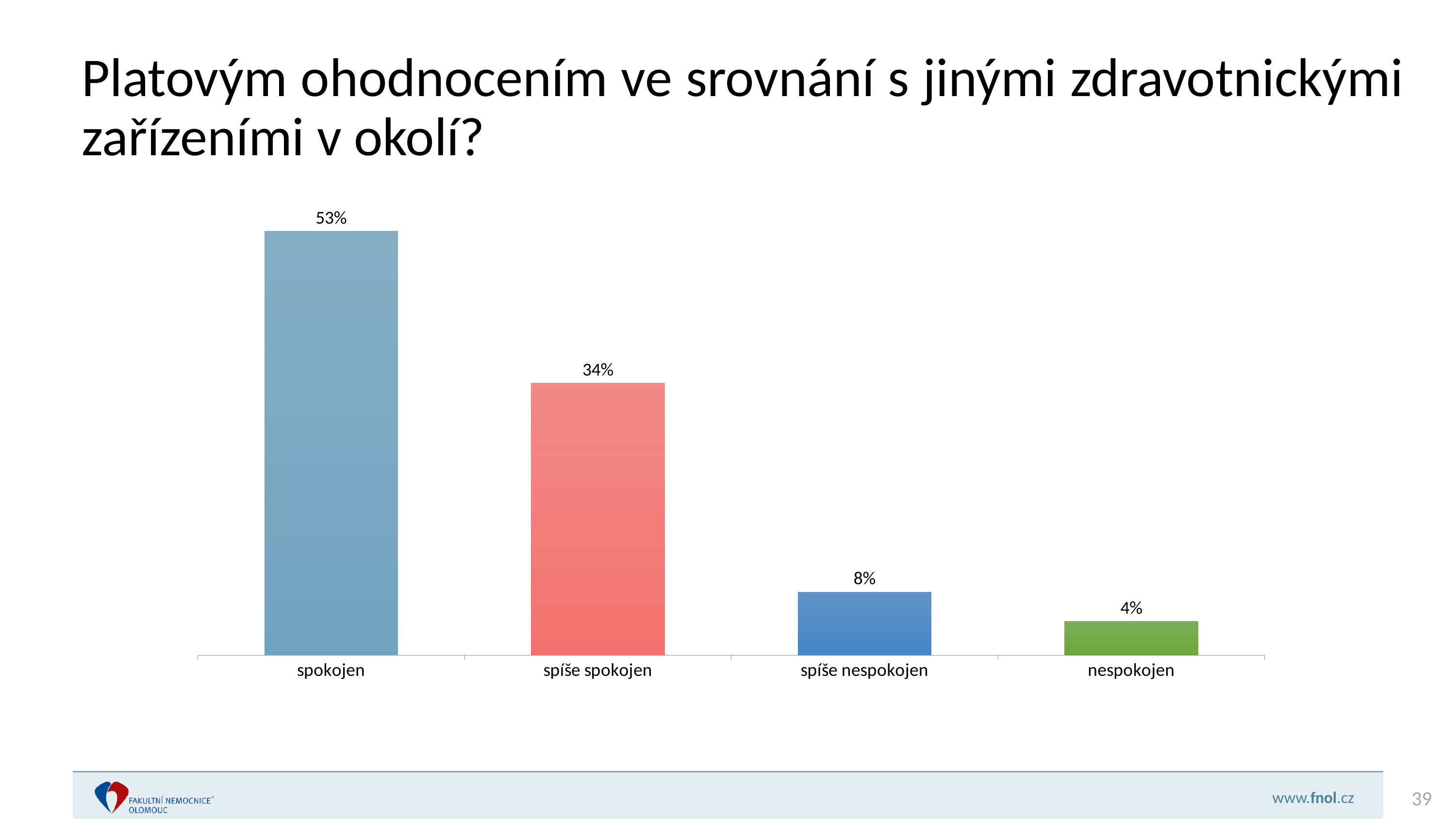
What is the difference between the values for "spokojen" and "spíše spokojen"? 19% What is the value for "nespokojen"? 4% What is the value for "spíše nespokojen"? 8% Do the values rise or fall from left to right along the x axis? fall What is the difference between the values for "spíše nespokojen" and "nespokojen"? 4% What is the value for "spokojen"? 53% Which category has the highest value? spokojen Which is larger, the value for "spíše spokojen" or the value for "spíše nespokojen"? spíše spokojen What kind of chart is shown on the slide? bar chart How many categories are shown in the chart? 4 What is the value for "spíše spokojen"? 34% Which category has the lowest value? nespokojen